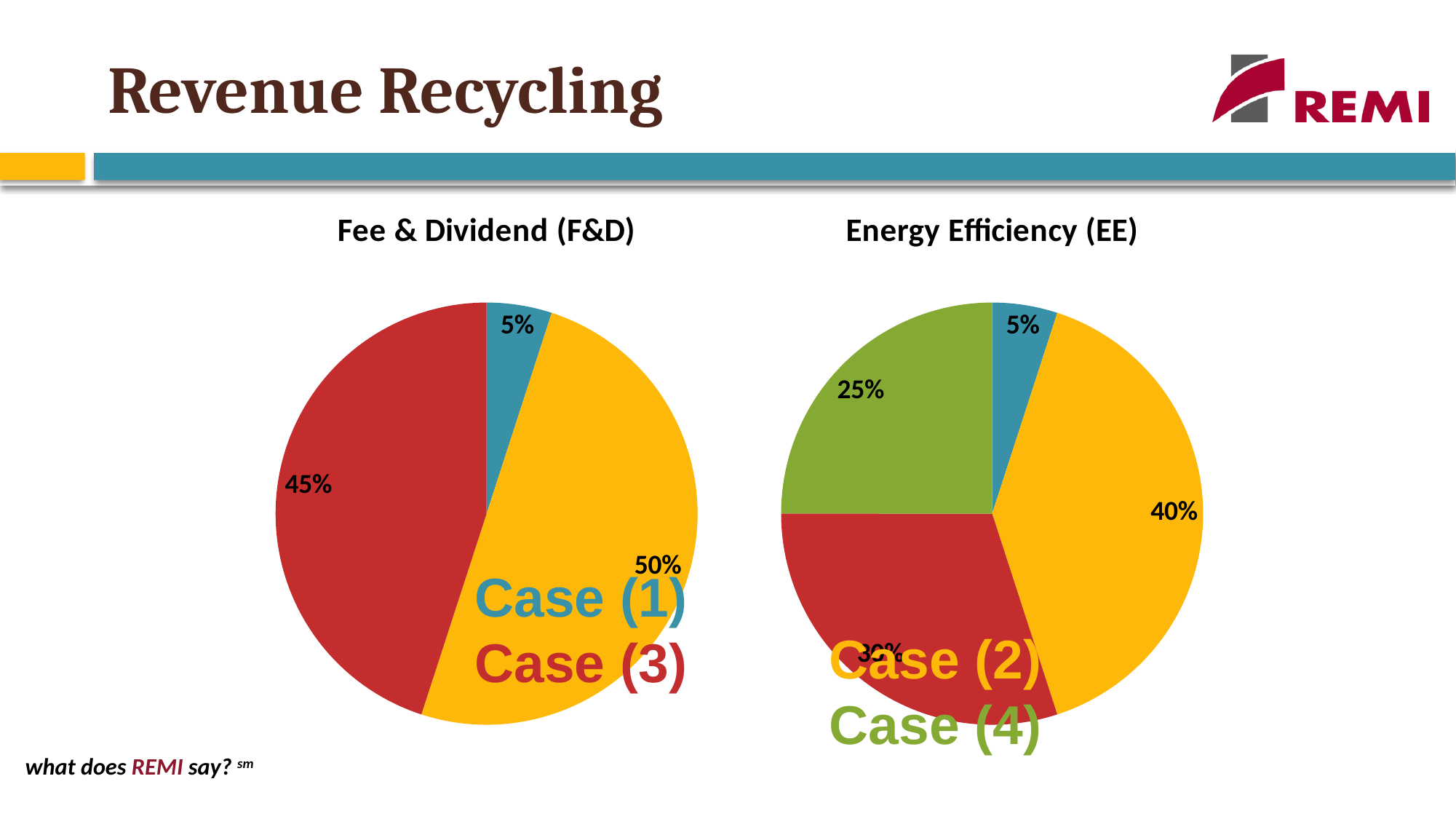
In the Fee & Dividend (F&D) chart, what is the value of the red slice? 45% In the Energy Efficiency (EE) chart, what is the value of the largest slice? 40% How many slices does the Energy Efficiency (EE) pie chart have? 4 In the Fee & Dividend (F&D) chart, what is the value of the smallest slice? 5% Which chart has the larger yellow slice, Fee & Dividend (F&D) or Energy Efficiency (EE)? Fee & Dividend (F&D) In the Energy Efficiency (EE) chart, what is the difference between the yellow slice and the green slice? 15 percentage points In the Fee & Dividend (F&D) chart, what is the value of the largest slice? 50% In the Fee & Dividend (F&D) chart, what is the difference between the yellow slice and the red slice? 5 percentage points In the Energy Efficiency (EE) chart, what is the value of the green slice? 25% How many slices does the Fee & Dividend (F&D) pie chart have? 3 In the Energy Efficiency (EE) chart, what is the value of the blue slice? 5% What kind of chart is the Fee & Dividend (F&D) chart? pie chart